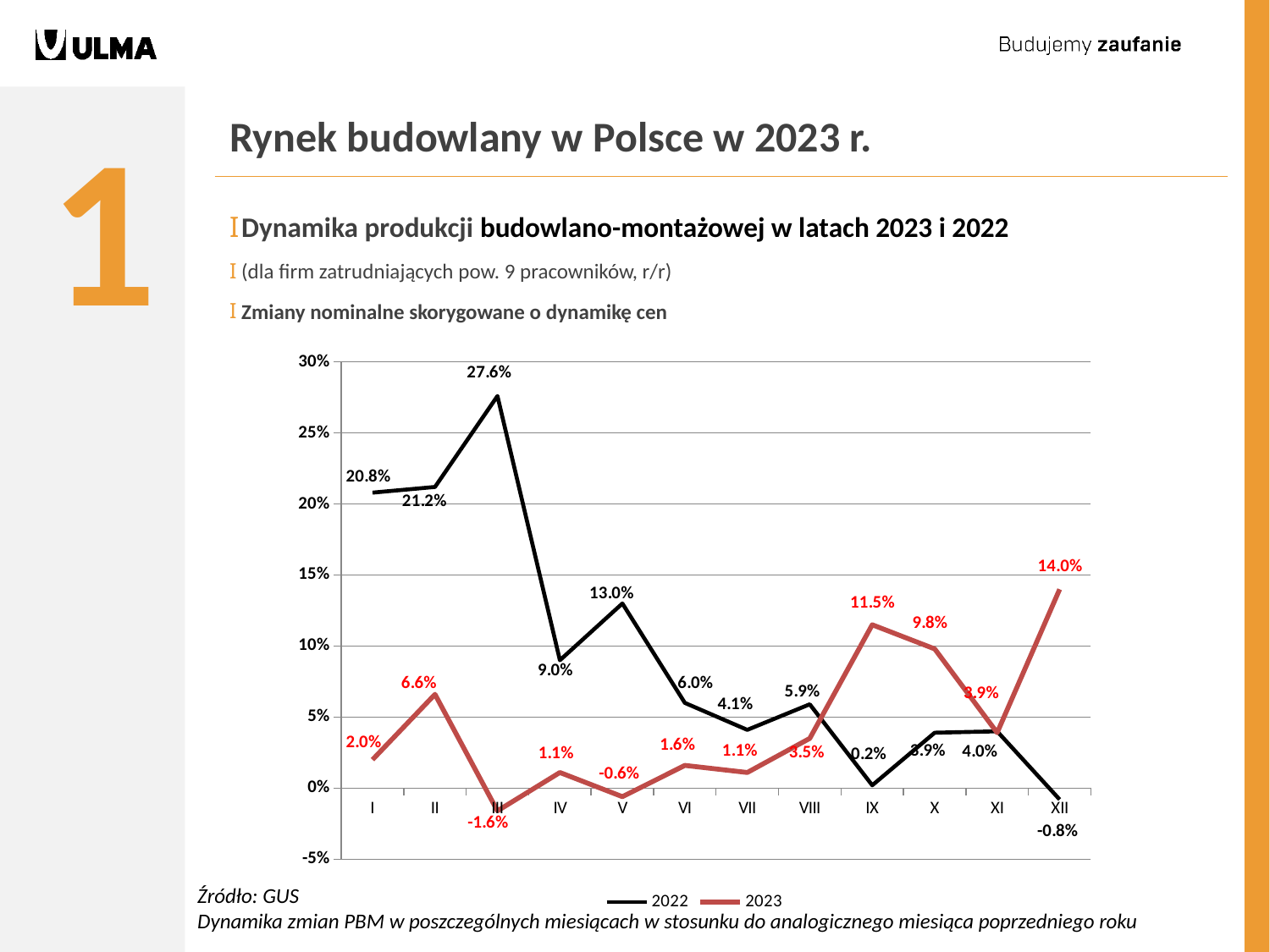
What colour is the line for the 2023 series? red What is the value for the 2023 series in month XII? 14.0% Which series has the larger value in month X, 2022 or 2023? 2023 What is the difference between the 2022 and 2023 values in month I? 18.8 percentage points How many series does the legend list? 2 What is the value for the 2023 series in month IX? 11.5% Does the 2022 series generally rise or fall from month III to month XII? fall What type of chart is shown on the slide? line chart What is the value for the 2022 series in month III? 27.6% In which month does the 2023 series have its lowest value? III In which month does the 2022 series reach its highest value? III How many months (categories) are plotted on the x axis? 12